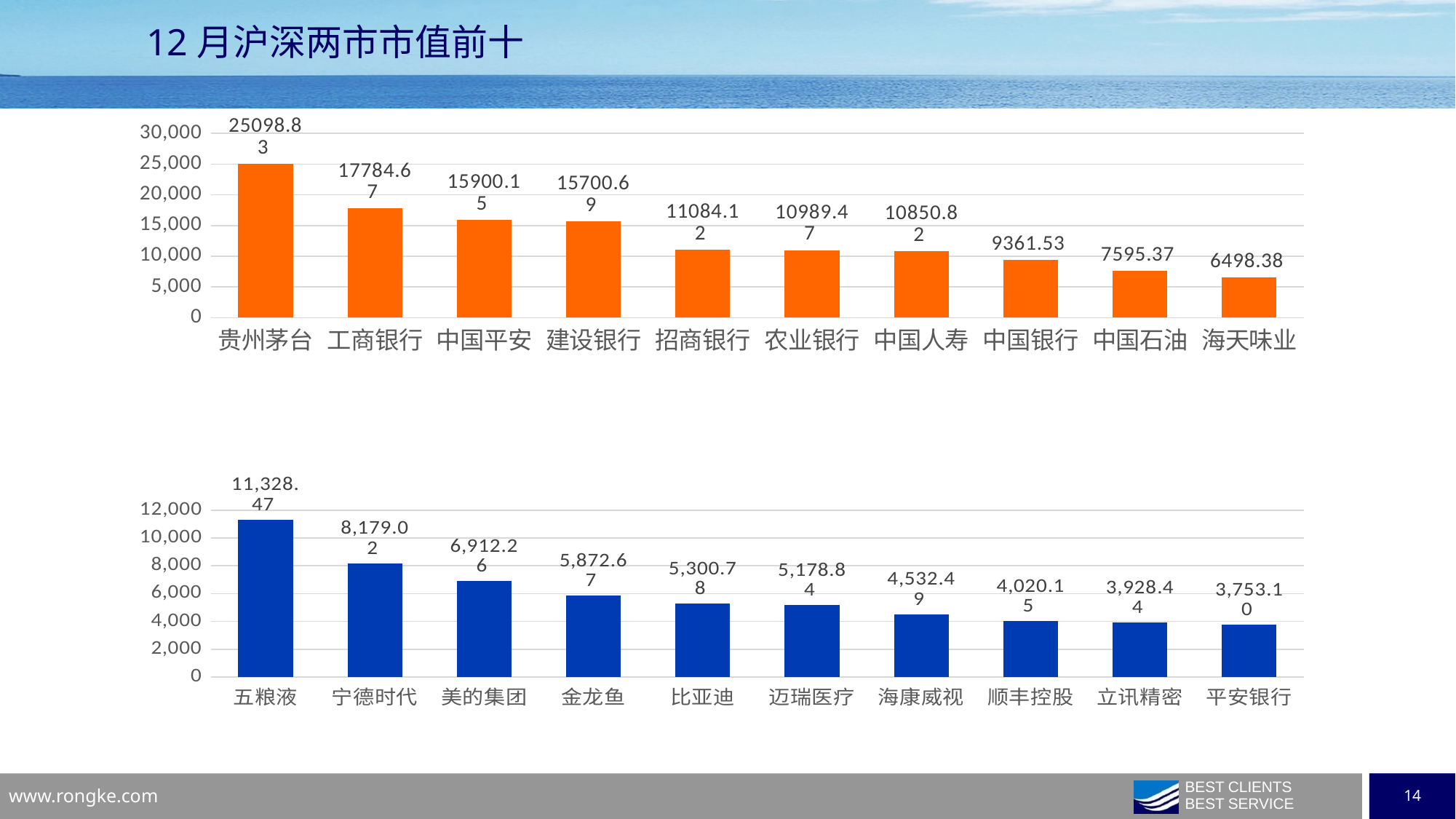
In the bottom chart, what is the value for 五粮液? 11,328.47 In the top chart, what is the value for 中国银行? 9361.53 In the top chart, what is the difference between the values for 贵州茅台 and 工商银行? 7314.16 In the top chart, which category has the lowest value? 海天味业 In the bottom chart, what is the difference between the values for 五粮液 and 宁德时代? 3,149.45 In the bottom chart, what is the value for 平安银行? 3,753.10 In the top chart, what is the value for 贵州茅台? 25098.83 In the bottom chart, do the values rise or fall from left to right along the x axis? fall In the bottom chart, which category has the highest value? 五粮液 What type of chart is the top chart? bar chart In the top chart, how many categories are shown? 10 In the top chart, which is larger, the value for 招商银行 or 中国人寿? 招商银行